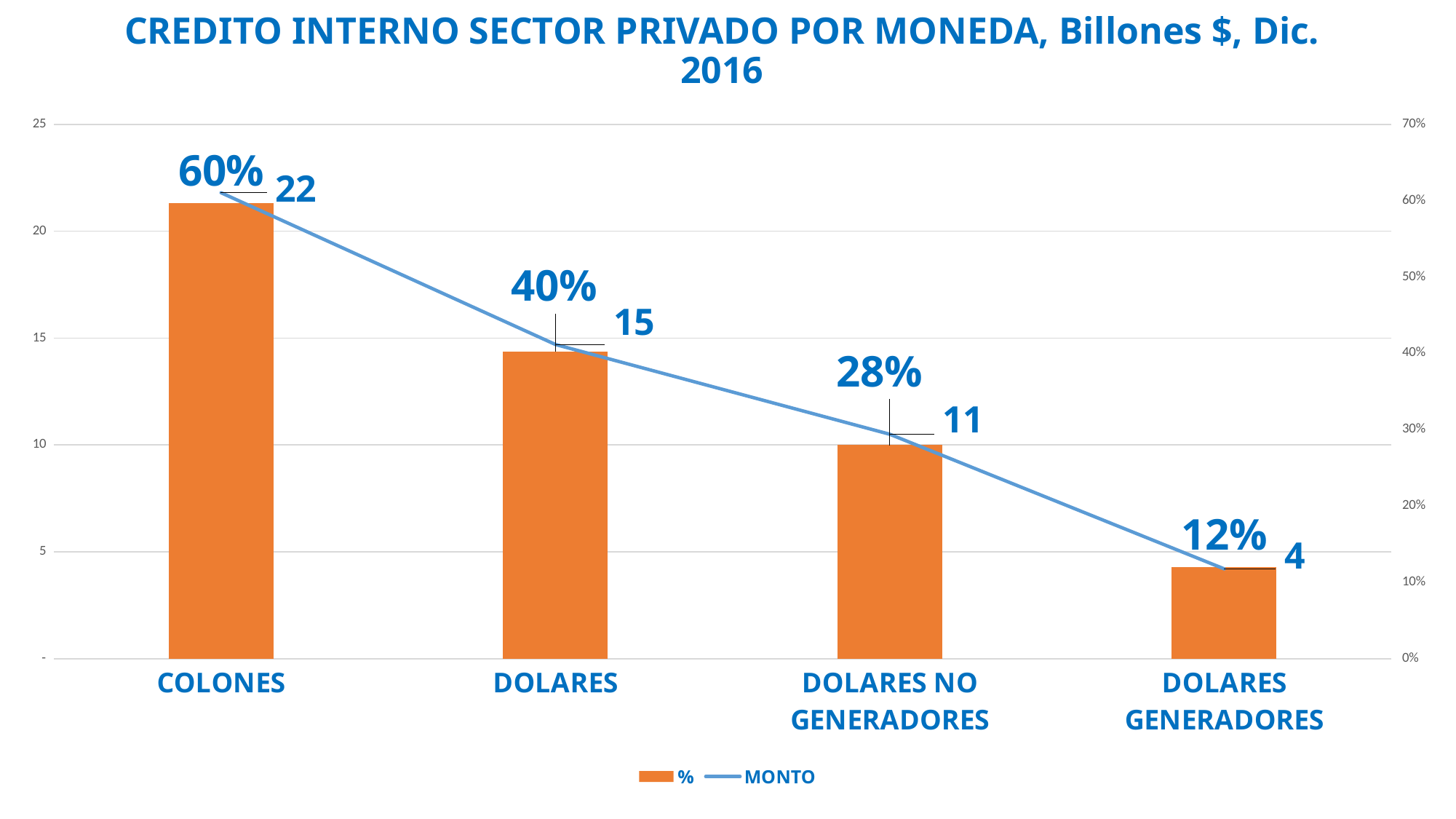
What percentage is shown for COLONES? 60% What is the title of the chart? CREDITO INTERNO SECTOR PRIVADO POR MONEDA, Billones $, Dic. 2016 How many categories are shown on the x axis? 4 What percentage is shown for DOLARES NO GENERADORES? 28% Which category has the lowest percentage? DOLARES GENERADORES What is the difference between the MONTO values for COLONES and DOLARES? 7 What MONTO value is shown for DOLARES? 15 What MONTO value is shown for DOLARES GENERADORES? 4 Which has a larger MONTO value, DOLARES or DOLARES NO GENERADORES? DOLARES Do the MONTO values rise or fall from left to right along the x axis? fall How many series does the legend list? 2 Which category has the highest MONTO value? COLONES